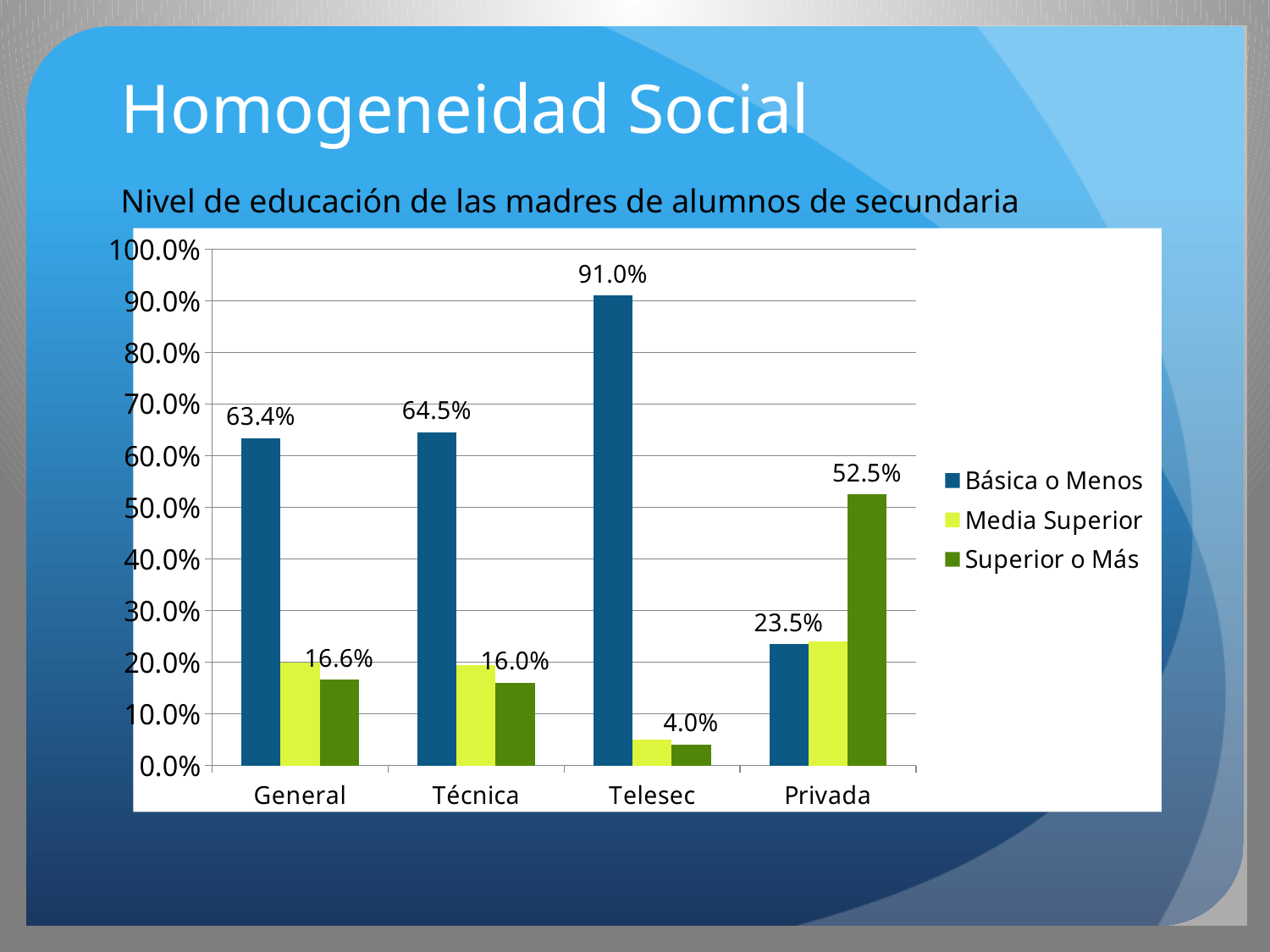
How many series does the legend list? 3 How many categories are shown on the x axis? 4 Which is larger: Básica o Menos for Técnica or Básica o Menos for General? Básica o Menos for Técnica What is the value for Básica o Menos in the General category? 63.4% What is the value for Superior o Más in the Privada category? 52.5% What kind of chart is shown on the slide? Bar chart What is the difference between the Básica o Menos values for Telesec and Privada? 67.5% Which category has the lowest value for Superior o Más? Telesec Is the value for Media Superior in the Privada category greater or less than 20.0%? greater Which category has the highest value for Básica o Menos? Telesec What is the value for Superior o Más in the Telesec category? 4.0% What is the value for Básica o Menos in the Telesec category? 91.0%